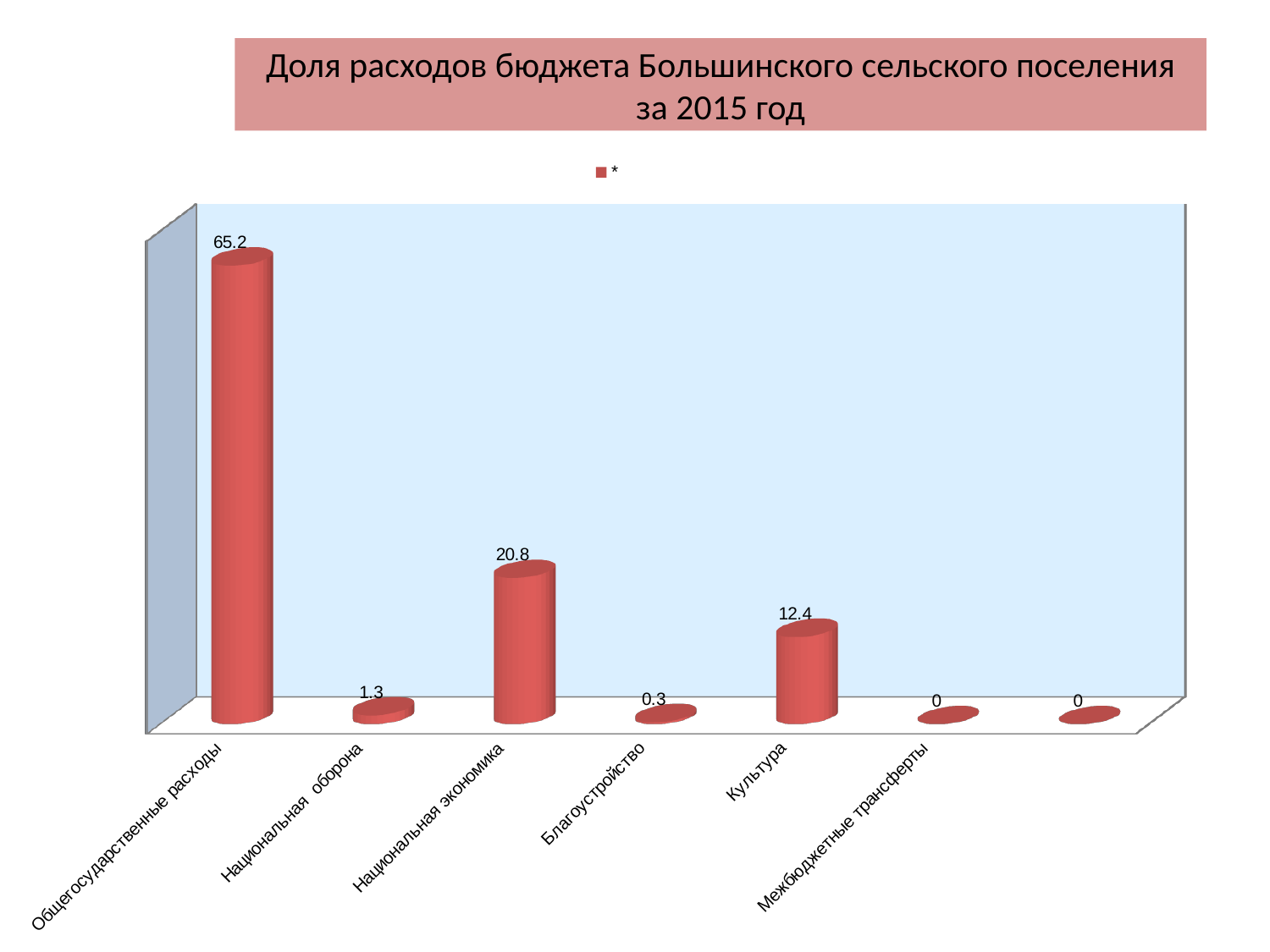
What kind of chart is shown on the slide? Bar chart What is the value for Благоустройство? 0.3 What is the difference between the values for Национальная экономика and Культура? 8.4 Which category has the highest value? Общегосударственные расходы What is the value for Общегосударственные расходы? 65.2 What is the difference between the values for Общегосударственные расходы and Национальная экономика? 44.4 What is the title of the chart? Доля расходов бюджета Большинского сельского поселения за 2015 год What is the value for Межбюджетные трансферты? 0 What is the value for Национальная оборона? 1.3 What is the value for Национальная экономика? 20.8 Which is larger, the value for Культура or the value for Национальная оборона? Культура What is the value for Культура? 12.4